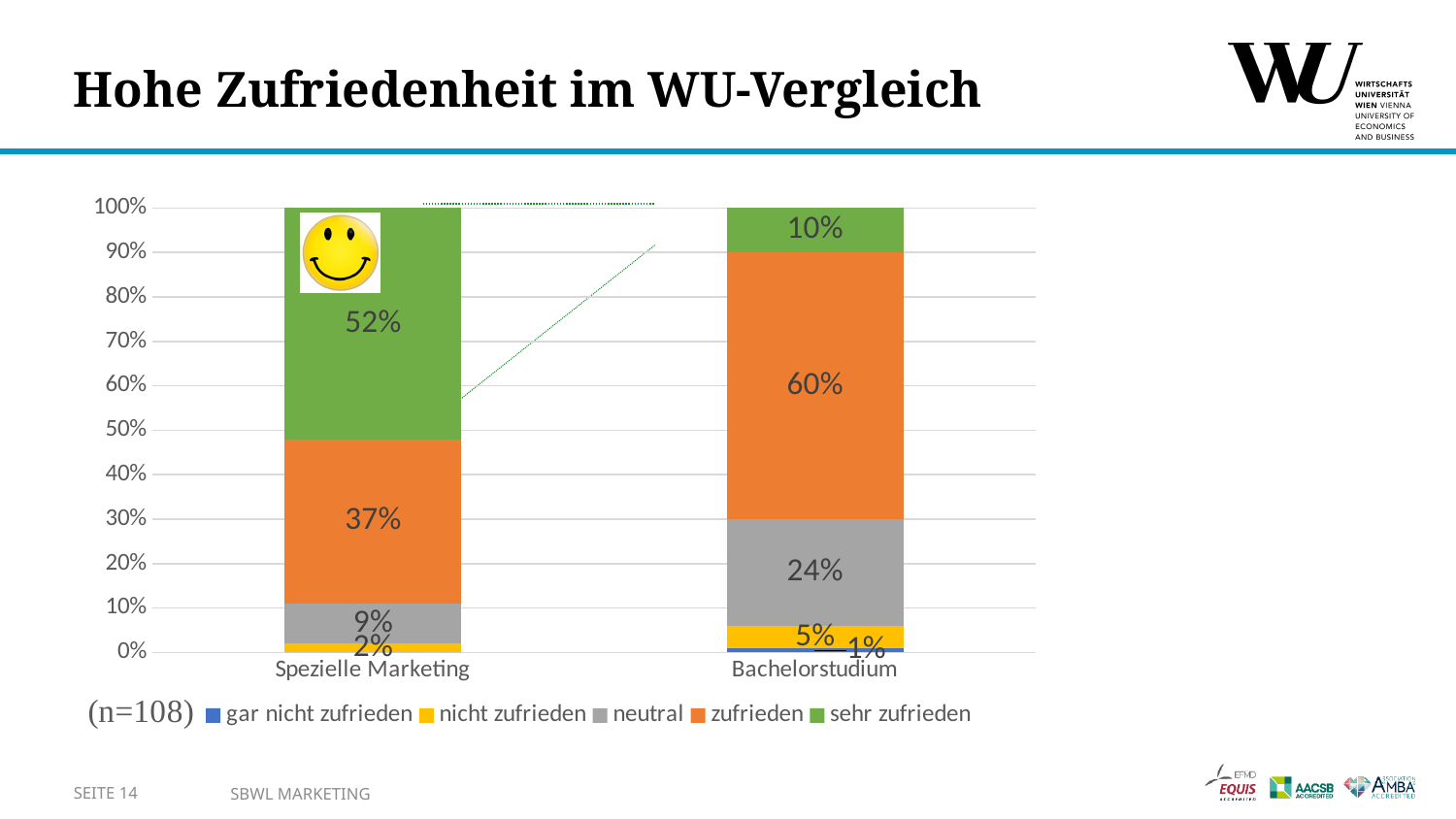
What is the value for "zufrieden" in the Bachelorstudium bar? 60% What kind of chart is shown on the slide? stacked bar chart What is the value for "gar nicht zufrieden" in the Bachelorstudium bar? 1% How many categories are shown on the x axis? 2 What is the difference between the "neutral" values for Bachelorstudium and Spezielle Marketing? 15% How many series does the legend list? 5 What sample size is noted next to the legend? n=108 What is the difference between the "zufrieden" values for Bachelorstudium and Spezielle Marketing? 23% Which category has the higher value for "sehr zufrieden", Spezielle Marketing or Bachelorstudium? Spezielle Marketing What is the value for "neutral" in the Bachelorstudium bar? 24% What is the value for "sehr zufrieden" in the Spezielle Marketing bar? 52% What is the value for "nicht zufrieden" in the Spezielle Marketing bar? 2%